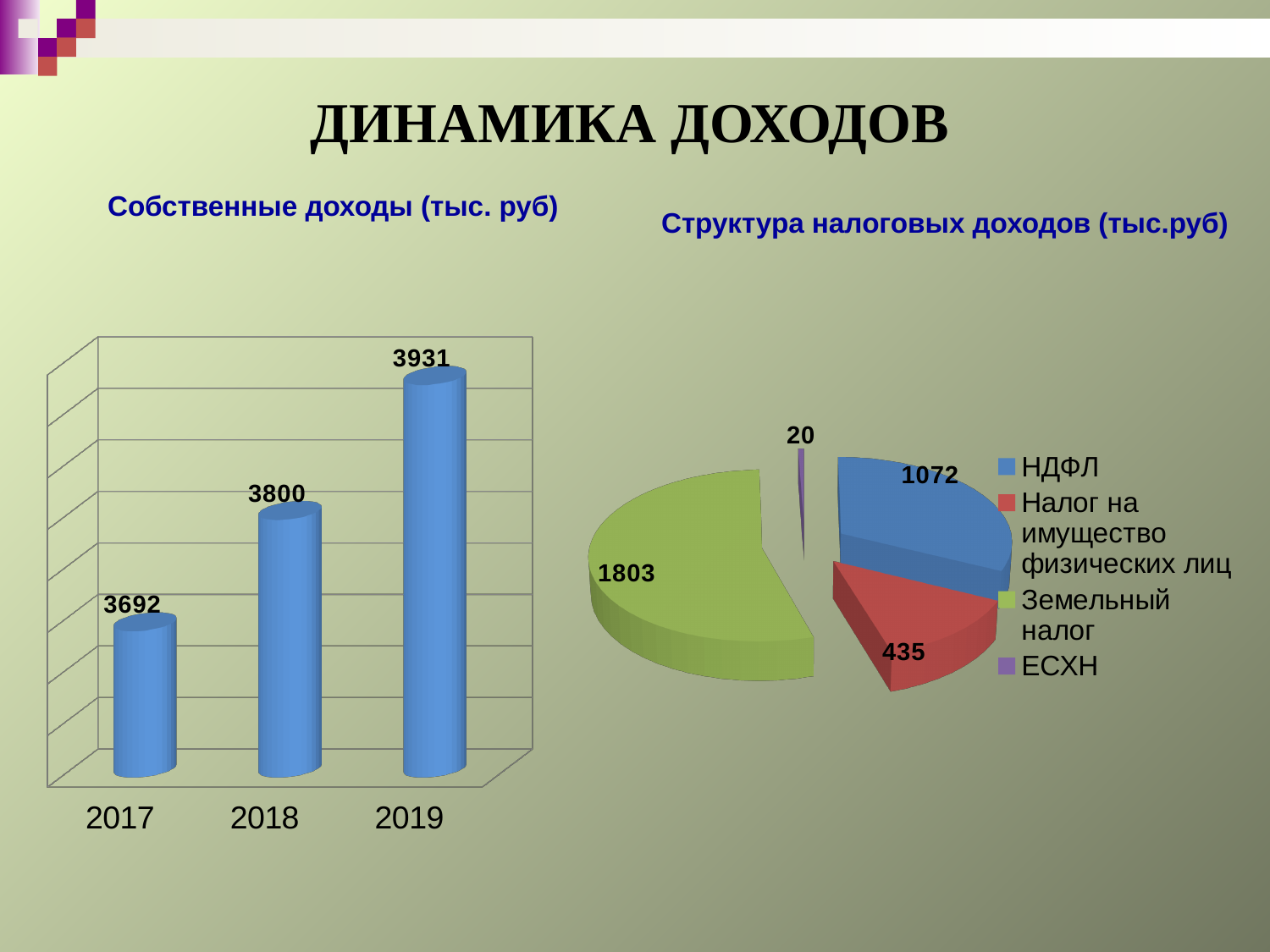
In the 'Собственные доходы (тыс. руб)' chart, what is the value for 2018? 3800 In the 'Собственные доходы (тыс. руб)' chart, what is the value for 2017? 3692 In the 'Структура налоговых доходов (тыс.руб)' chart, what is the value for ЕСХН? 20 In the 'Собственные доходы (тыс. руб)' chart, what is the difference between the 2019 and 2017 values? 239 How many categories does the legend of the 'Структура налоговых доходов (тыс.руб)' chart list? 4 What kind of chart is the 'Собственные доходы (тыс. руб)' chart? bar chart In the 'Структура налоговых доходов (тыс.руб)' chart, which category has the largest slice? Земельный налог In the 'Собственные доходы (тыс. руб)' chart, which year has the highest value? 2019 In the 'Структура налоговых доходов (тыс.руб)' chart, what is the value for Земельный налог? 1803 In the 'Собственные доходы (тыс. руб)' chart, do the values rise or fall from 2017 to 2019? rise In the 'Структура налоговых доходов (тыс.руб)' chart, which is larger: НДФЛ or Налог на имущество физических лиц? НДФЛ In the 'Собственные доходы (тыс. руб)' chart, which year has the lowest value? 2017